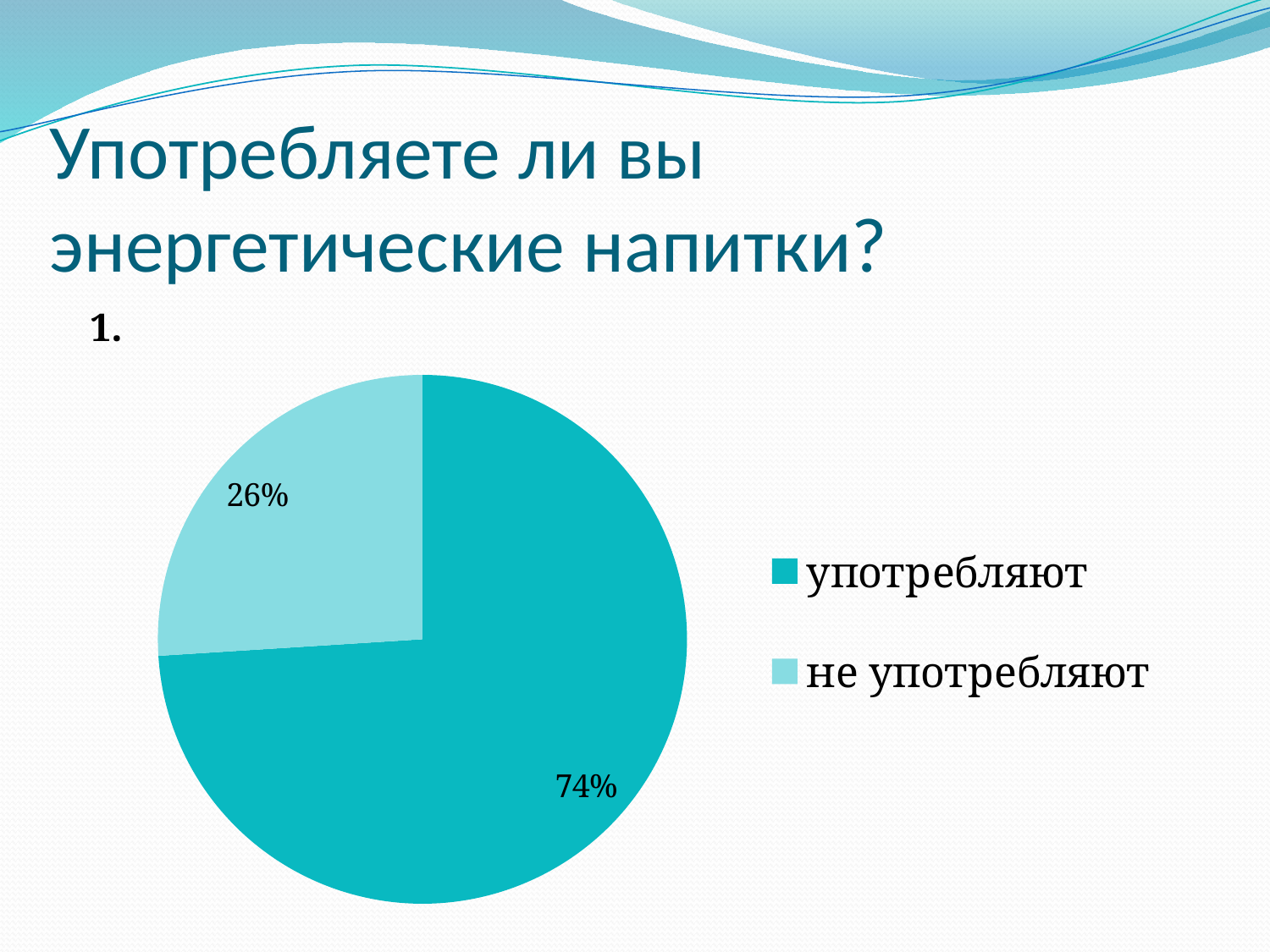
What kind of chart is shown on the slide? pie chart Is the share for "употребляют" greater or less than 50%? greater What is the title of the slide containing the chart? Употребляете ли вы энергетические напитки? What share of the pie is labelled "употребляют"? 74% What share of the pie is labelled "не употребляют"? 26% What is the difference in percentage points between the "употребляют" and "не употребляют" slices? 48 How many entries does the legend list? 2 How many slices does the pie chart have? 2 Which legend entry is shown in the lighter shade of blue? не употребляют Which slice is larger, "употребляют" or "не употребляют"? употребляют Which category has the largest slice of the pie? употребляют Which category has the smallest slice of the pie? не употребляют